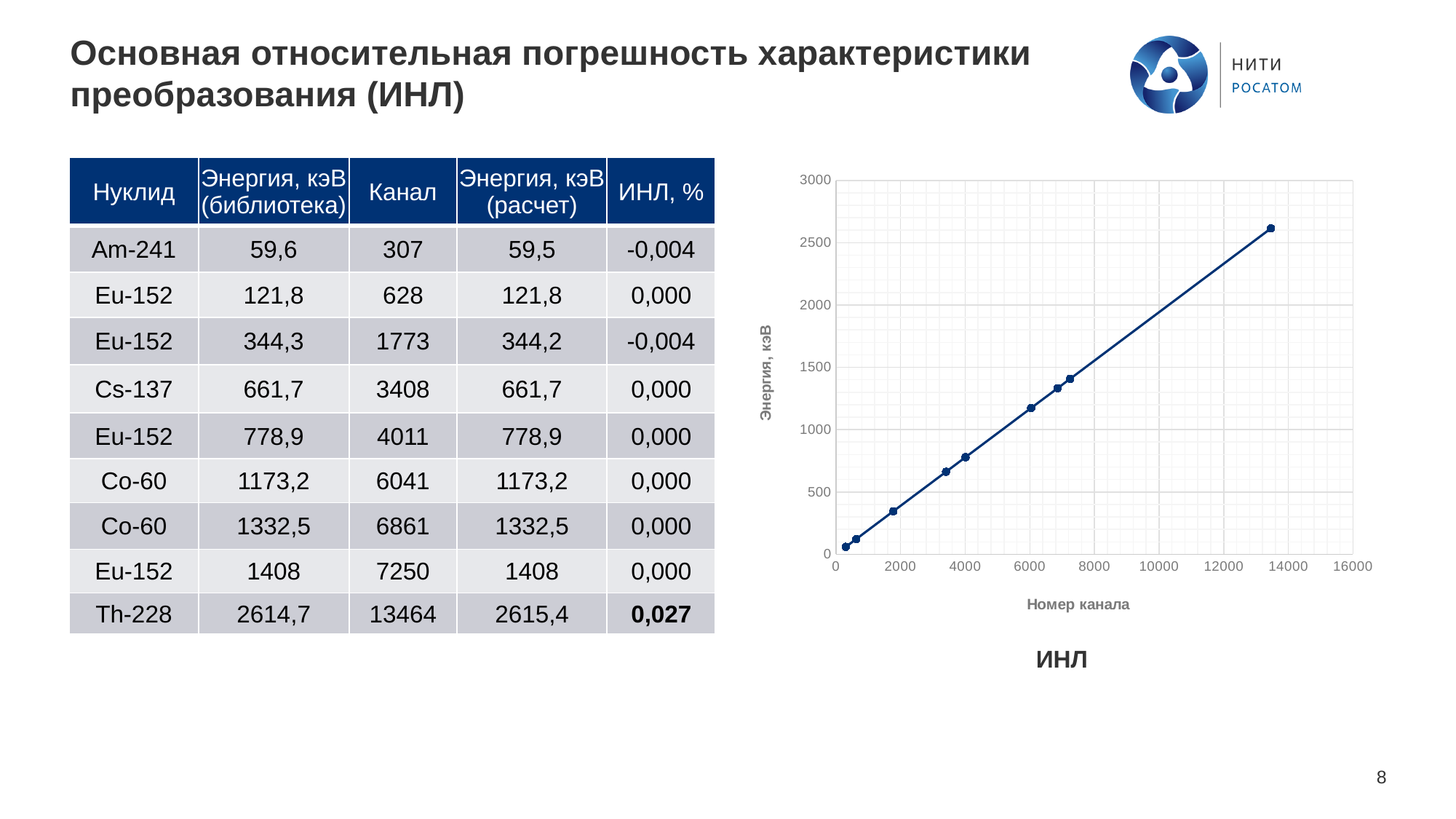
Is the energy value of the point plotted near channel 3400 greater or less than 500? greater What kind of chart is shown on the right side of the slide? line chart Is the energy value of the point plotted near channel 7250 greater or less than 1500? less Is the energy value of the rightmost plotted point (near channel 13464) greater or less than 2500? greater What is the maximum value shown on the y axis of the chart? 3000 Do the plotted energy values rise or fall as the channel number increases along the x axis? rise How many data points are plotted on the chart? 9 What is the title of the x axis of the chart? Номер канала